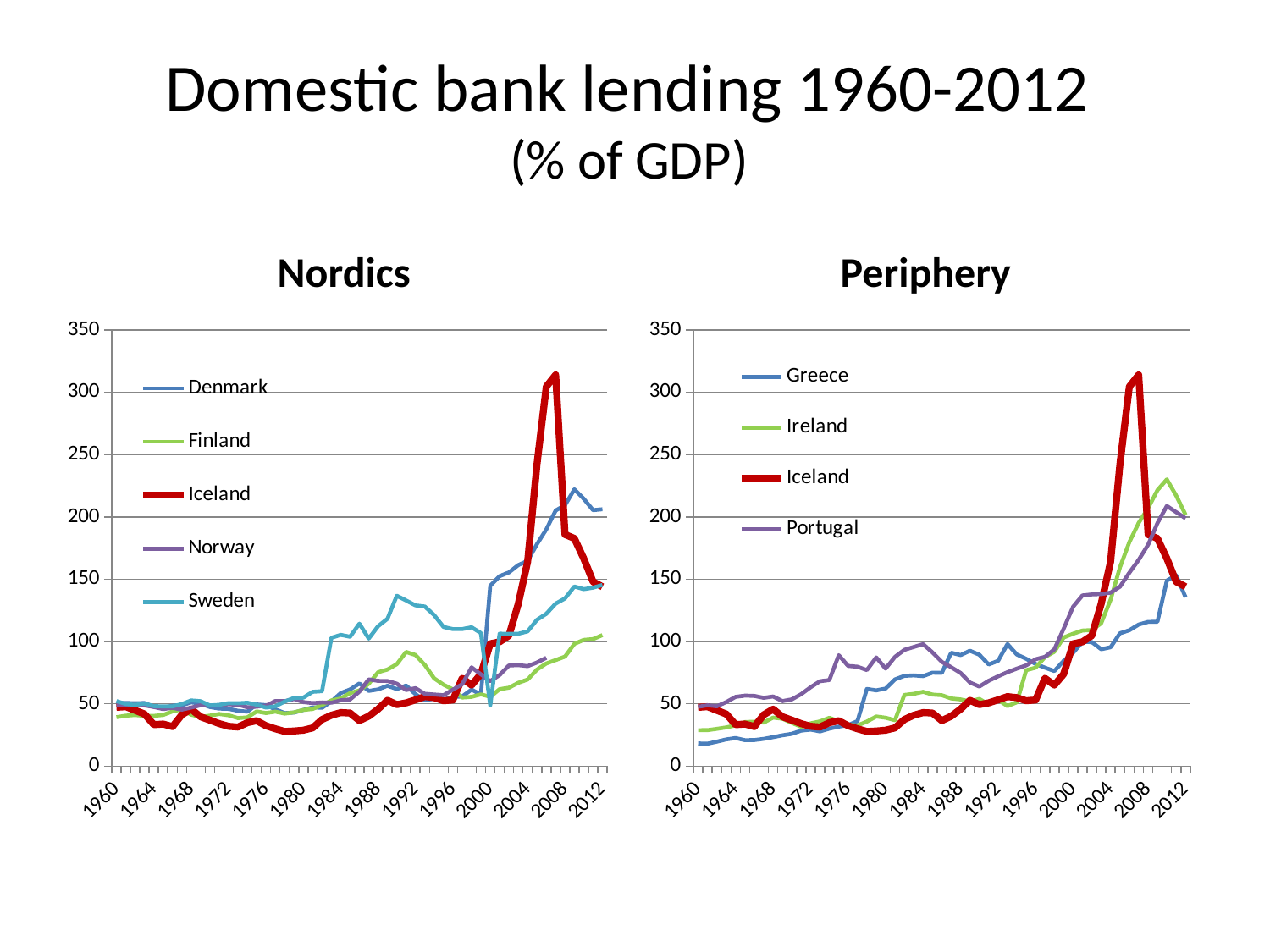
In the Nordics chart, is the value for Sweden in 1992 greater or less than 100? greater In the Periphery chart, which series reaches the highest value? Iceland In the Nordics chart, which is larger in 2007, Iceland or Finland? Iceland In the Nordics chart, is the peak value for Iceland around 2007 greater or less than 300? greater Which series appears in the legends of both charts? Iceland In the Periphery chart, which series has the lowest value in 1960? Greece What kind of chart is the Nordics chart? line chart In the Periphery chart, does the value for Greece generally rise or fall from 1960 to 2012? rise How many series does the legend of the Periphery chart list? 4 In the Periphery chart, is the value for Greece in 1960 greater or less than 50? less In the Nordics chart, which series reaches the highest value? Iceland How many series does the legend of the Nordics chart list? 5